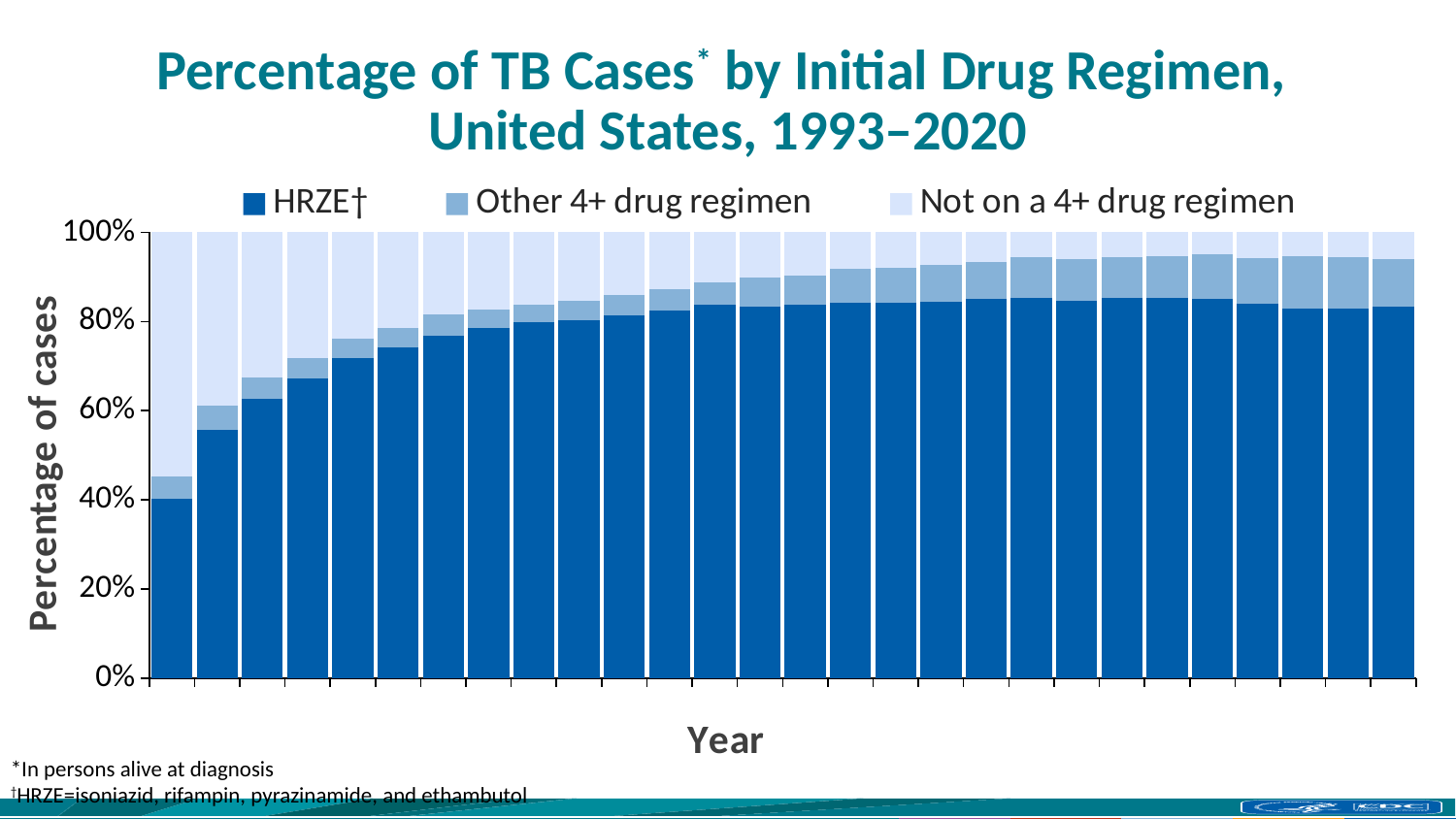
Is the HRZE† value for the leftmost bar (1993) greater or less than 60%? less What are the three series named in the legend? HRZE†, Other 4+ drug regimen, Not on a 4+ drug regimen How many series does the legend list? 3 Does the 'Not on a 4+ drug regimen' share generally rise or fall from left to right across the years? Fall Which has a larger HRZE† share: the leftmost bar (1993) or the rightmost bar (2020)? The rightmost bar (2020) What kind of chart is shown on the slide? Stacked bar chart Is the 'Not on a 4+ drug regimen' portion of the leftmost bar (1993) greater or less than 40%? greater How many bars (years) are plotted in the chart? 28 What is the title of the vertical axis? Percentage of cases Which bar has the smallest HRZE† share of cases? The leftmost bar (1993) Is the HRZE† value for the rightmost bar (2020) greater or less than 60%? greater Does the HRZE† share of cases generally rise or fall from left to right across the years? Rise